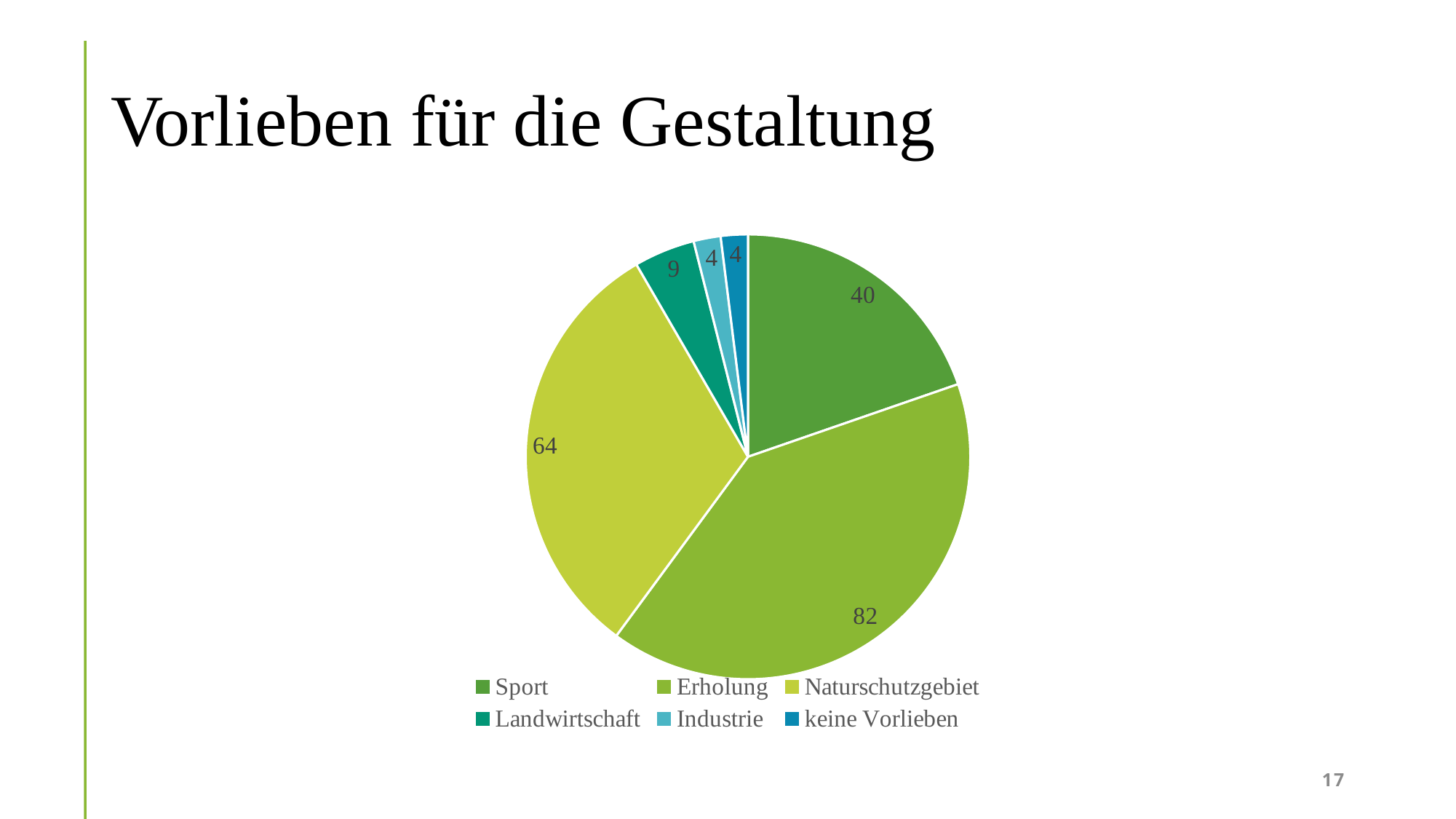
Which is larger, the value for Sport or the value for Naturschutzgebiet? Naturschutzgebiet What kind of chart is shown on the slide? pie chart What value is shown for the Landwirtschaft slice? 9 What value is shown for the Sport slice? 40 What is the title of the slide containing the chart? Vorlieben für die Gestaltung What is the difference between the values for Erholung and Naturschutzgebiet? 18 What is the difference between the values for Sport and Landwirtschaft? 31 Which category has the largest slice of the pie? Erholung What value is shown for the Industrie slice? 4 What value is shown for the Erholung slice? 82 How many categories does the pie chart show? 6 What value is shown for the Naturschutzgebiet slice? 64